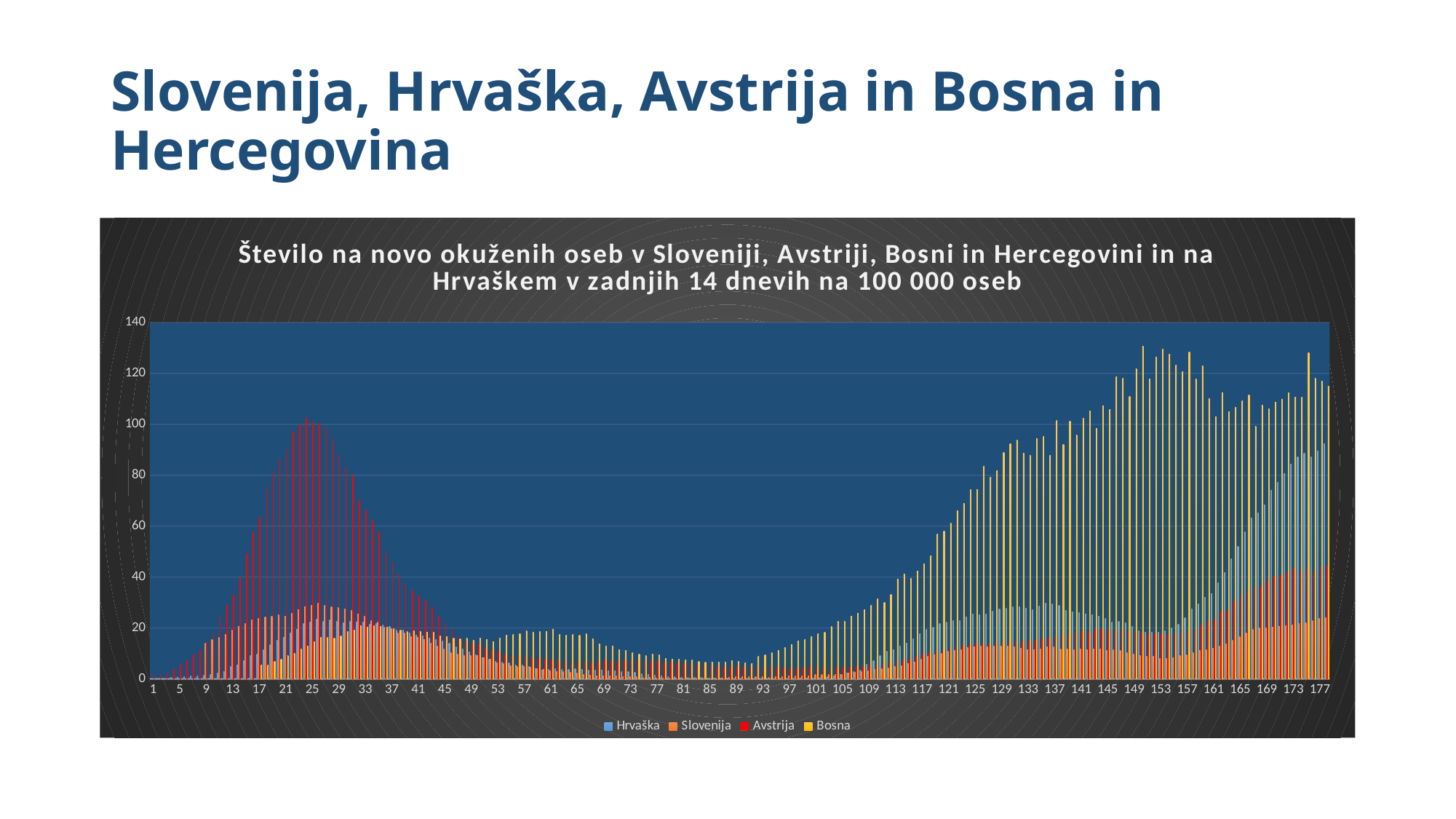
How many series does the chart's legend list? 4 Is the peak value for Bosna (around day 150) greater or less than 120? greater Is the peak value for Avstrija (around day 25) greater or less than 80? greater What is the title of the chart? Število na novo okuženih oseb v Sloveniji, Avstriji, Bosni in Hercegovini in na Hrvaškem v zadnjih 14 dnevih na 100 000 oseb Which series has the highest value around day 25? Avstrija Do the values for Bosna rise or fall between day 93 and day 149? rise Which colour represents Avstrija in the chart? red Which is larger: the peak value of Avstrija or the peak value of Bosna? Bosna What kind of chart is shown on the slide? bar chart What is the highest value shown on the y axis? 140 Which series has the highest value around day 150? Bosna Is the highest value for Slovenija anywhere in the chart greater or less than 40? less